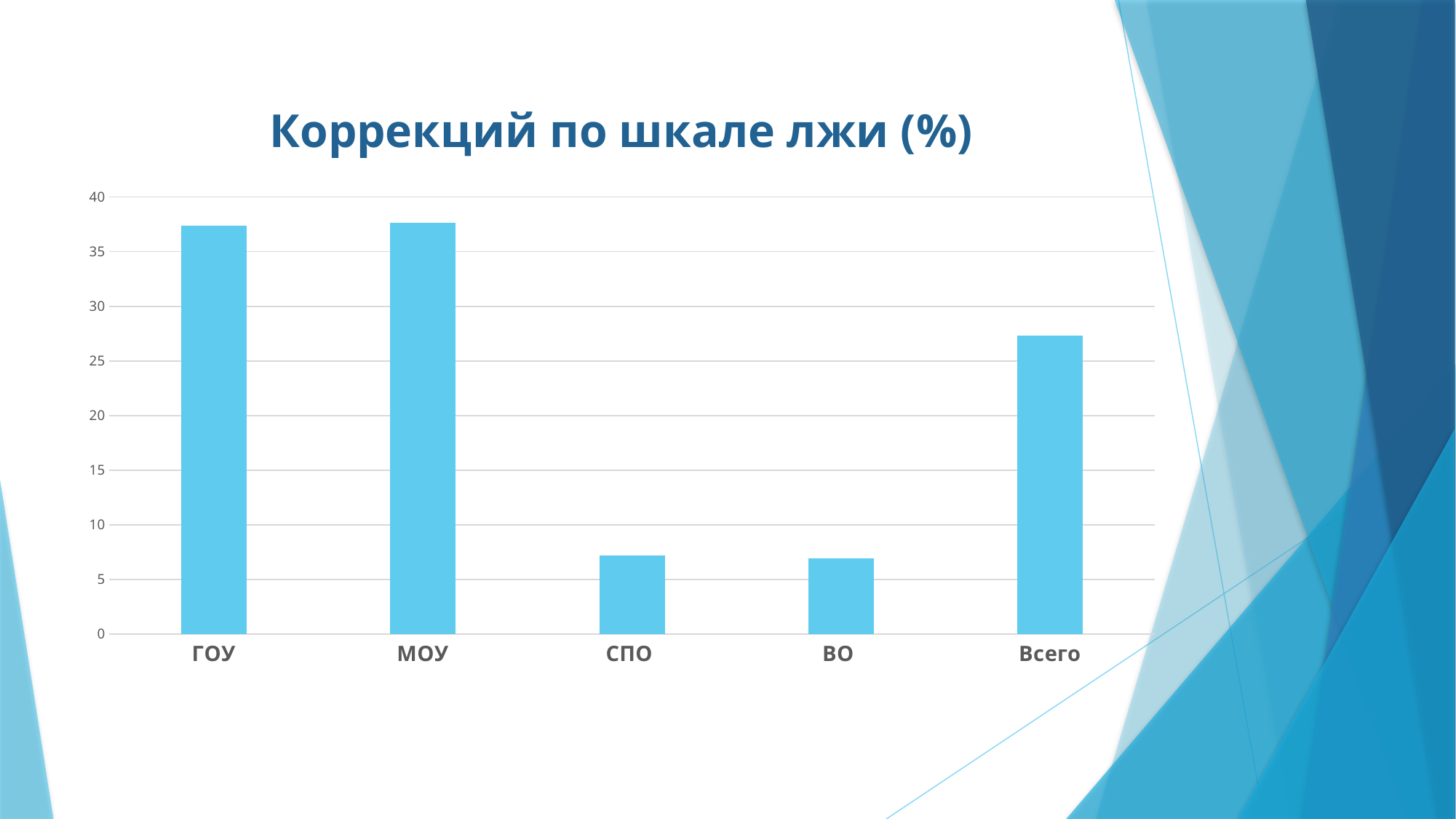
Is the value for Всего greater or less than 30? less Is the value for ВО greater or less than 5? greater Is the value for МОУ greater or less than 40? less Which is larger, the value for ВО or the value for Всего? Всего What kind of chart is shown on the slide? bar chart Which is larger, the value for ГОУ or the value for СПО? ГОУ How many categories are shown on the x axis of the chart? 5 What is the title of the chart? Коррекций по шкале лжи (%) Which is larger, the value for МОУ or the value for Всего? МОУ